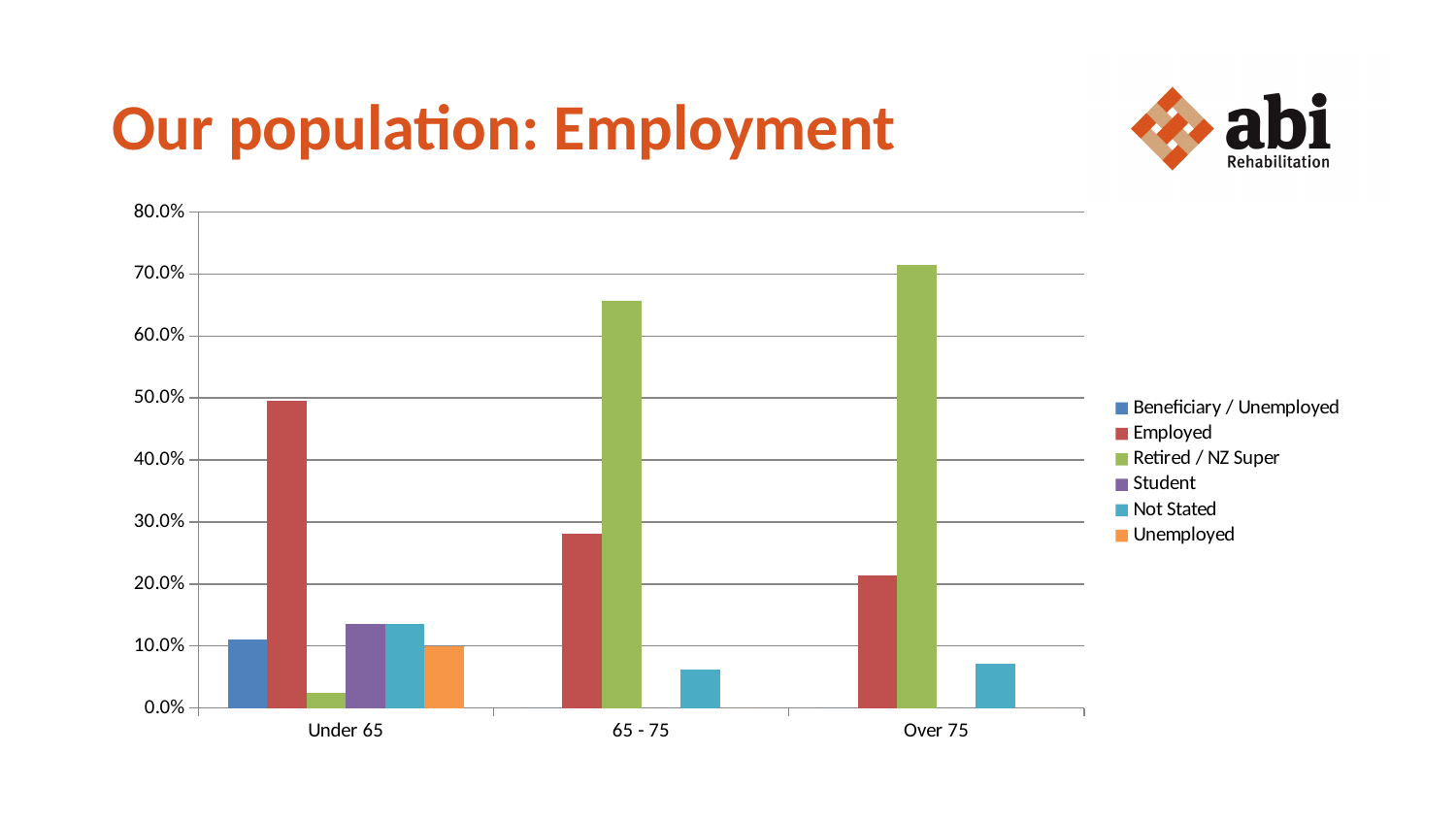
Which age group has the highest value for Retired / NZ Super? Over 75 How many series does the legend list? 6 Do the values for Employed rise or fall from Under 65 to Over 75? fall Which age group has the larger value for Employed: Under 65 or 65 - 75? Under 65 Is the value for Not Stated in the 65 - 75 group greater or less than 10.0%? less Is the value for Retired / NZ Super in the 65 - 75 group greater or less than 60.0%? greater Is the value for Employed in the Under 65 group greater or less than 40.0%? greater How many age group categories are shown on the x axis? 3 What is the title of the slide containing the chart? Our population: Employment Which employment category has the highest value in the Under 65 group? Employed Do the values for Retired / NZ Super rise or fall from Under 65 to Over 75? rise What kind of chart is shown on the slide? bar chart